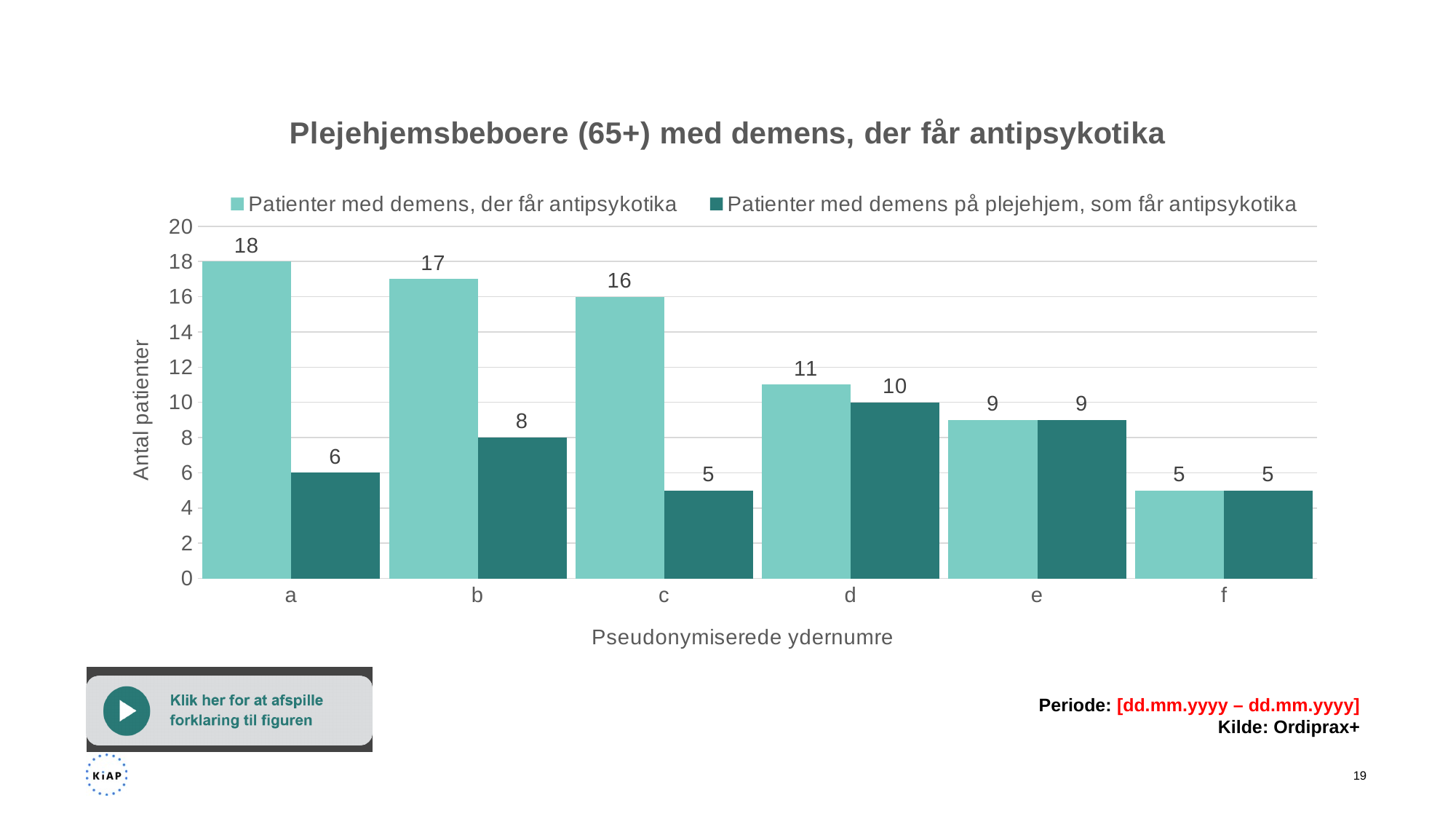
How many categories are shown on the x axis? 6 Is the value for category b in the series "Patienter med demens, der får antipsykotika" greater or less than 10? greater Which category has the highest value in the series "Patienter med demens, der får antipsykotika"? a What is the title of the chart? Plejehjemsbeboere (65+) med demens, der får antipsykotika How many series does the legend list? 2 What is the value for category d in the series "Patienter med demens på plejehjem, som får antipsykotika"? 10 Which category has the lowest value in the series "Patienter med demens på plejehjem, som får antipsykotika"? c For category b, which series has the larger value? Patienter med demens, der får antipsykotika Do the values of the series "Patienter med demens, der får antipsykotika" rise or fall from category a to category f? fall What is the difference between the two series for category c? 11 What is the value for category a in the series "Patienter med demens, der får antipsykotika"? 18 What kind of chart is shown on the slide? bar chart